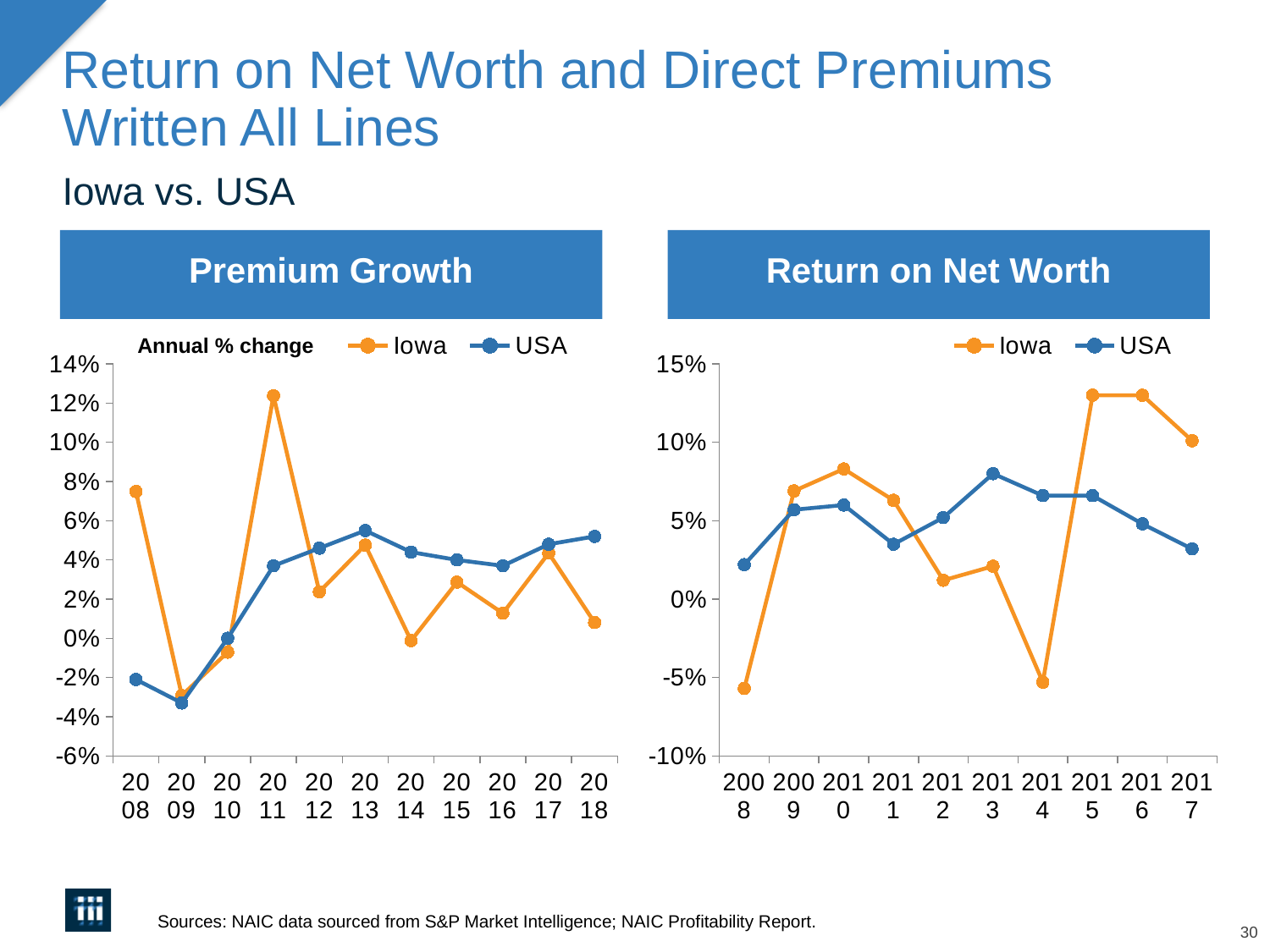
How many series does the legend of the Return on Net Worth chart list? 2 What kind of chart is the Premium Growth chart? line chart In the Premium Growth chart, is the Iowa value for 2011 greater or less than 10%? greater What colour is the Iowa line in the Premium Growth chart? orange In the Return on Net Worth chart, which series has the larger value in 2015, Iowa or USA? Iowa In the Return on Net Worth chart, in which year is the USA value highest? 2013 In the Premium Growth chart, in which year is the Iowa value highest? 2011 In the Premium Growth chart, is the USA value for 2009 greater or less than -2%? less In the Premium Growth chart, in which year is the USA value lowest? 2009 How many years are plotted on the x axis of the Return on Net Worth chart? 10 In the Return on Net Worth chart, is the Iowa value for 2014 greater or less than 0%? less How many years are plotted on the x axis of the Premium Growth chart? 11